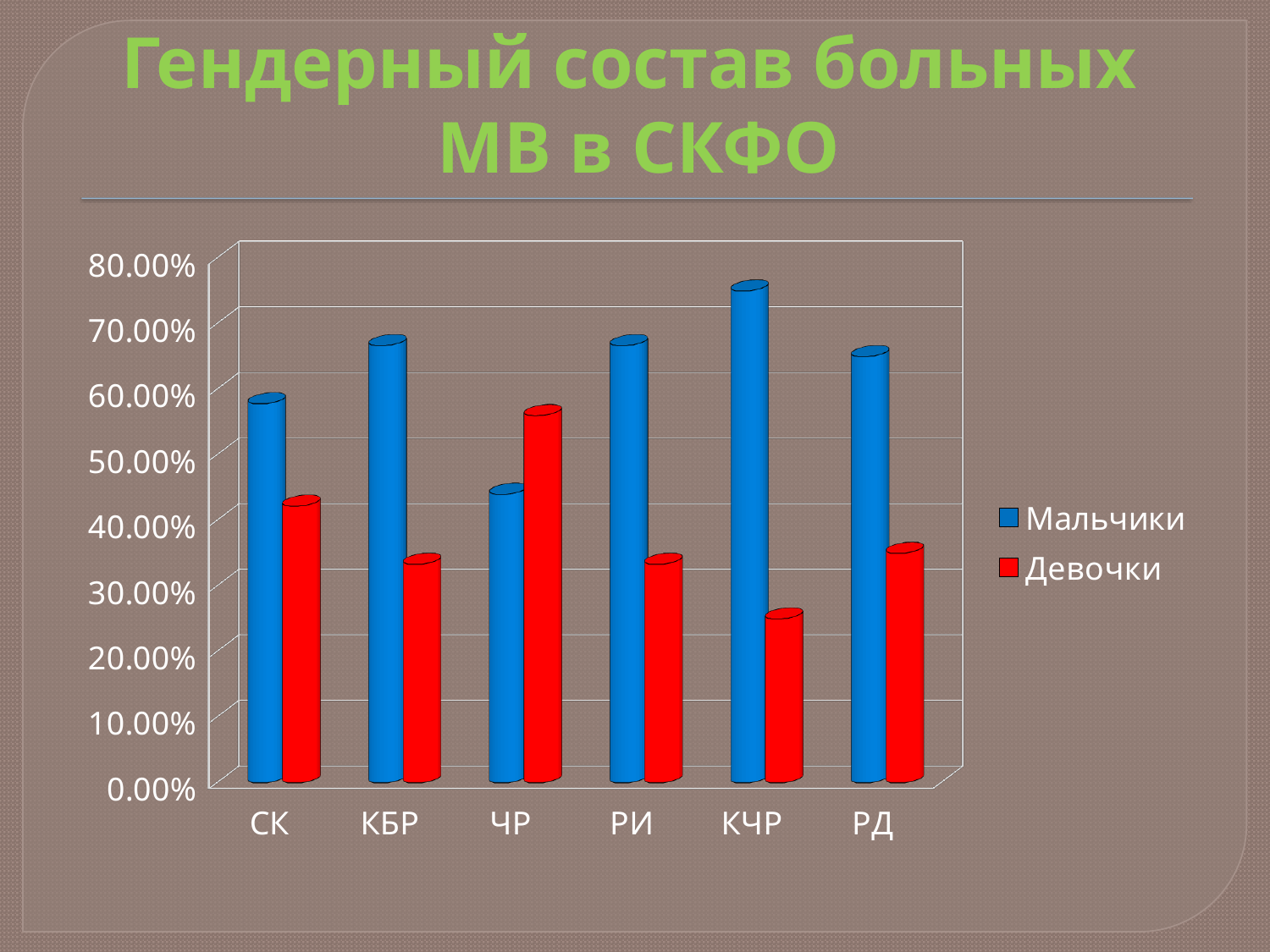
What kind of chart is shown on the slide? bar chart What are the two series named in the legend? Мальчики and Девочки Is the value for Мальчики in КЧР greater or less than 70.00%? greater Is the value for Мальчики in ЧР greater or less than 50.00%? less Which region has the highest value for Девочки? ЧР How many regions (categories) are shown on the x axis? 6 How many series does the legend list? 2 Which region has the highest value for Мальчики? КЧР Which region has the lowest value for Мальчики? ЧР In ЧР, which is larger: the value for Мальчики or for Девочки? Девочки Is the value for Девочки in КЧР greater or less than 30.00%? less Which region has the lowest value for Девочки? КЧР